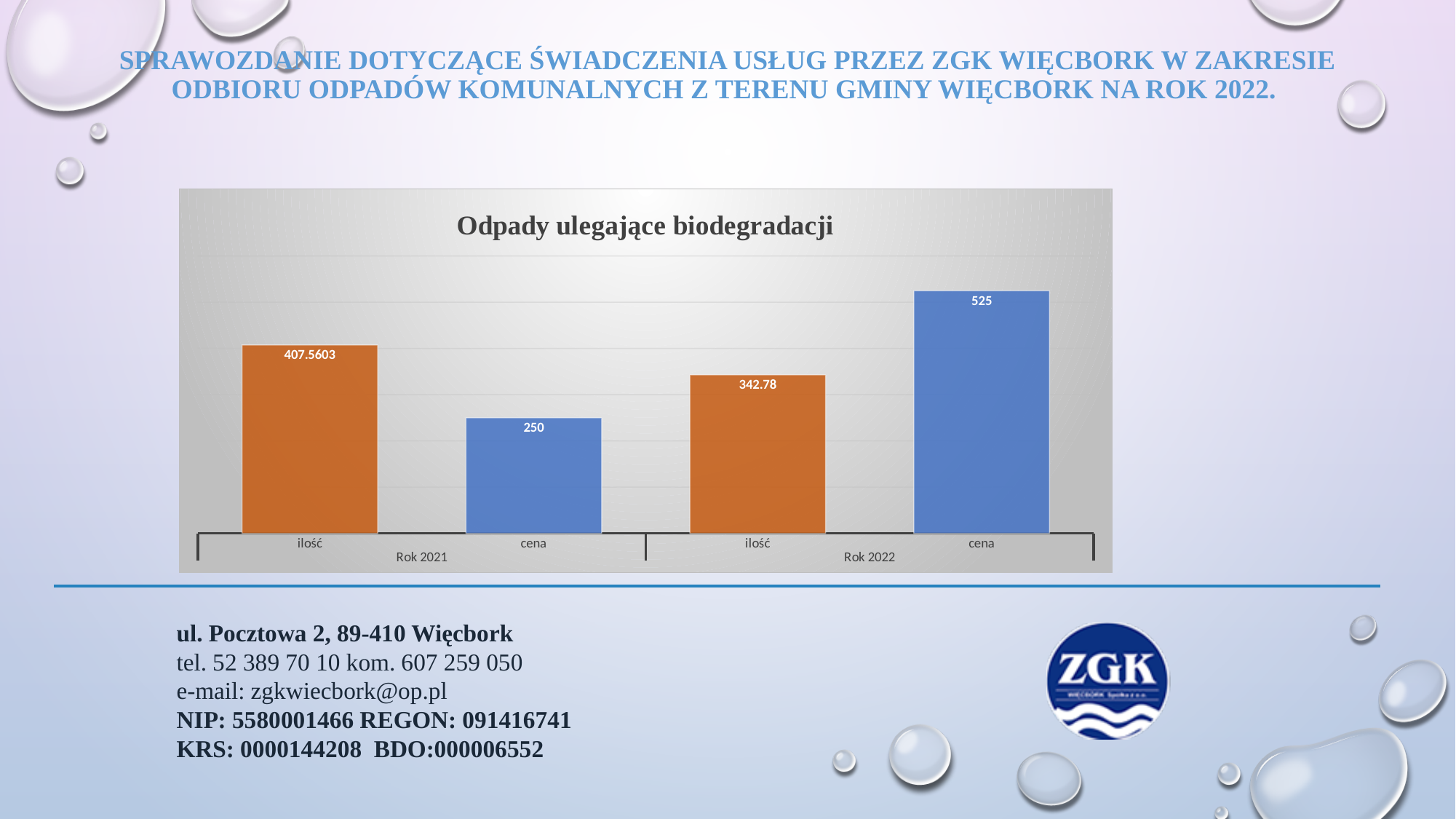
What is the difference between cena for Rok 2022 and cena for Rok 2021? 275 Which bar has the highest value in the chart? cena, Rok 2022 How many bars are plotted in the chart? 4 What is the value of cena for Rok 2022? 525 What is the value of ilość for Rok 2022? 342.78 Which bar has the lowest value in the chart? cena, Rok 2021 What type of chart is shown on the slide? bar chart Does the value of cena rise or fall from Rok 2021 to Rok 2022? rise What is the value of cena for Rok 2021? 250 Which is larger: ilość for Rok 2021 or ilość for Rok 2022? ilość for Rok 2021 What is the title of the chart? Odpady ulegające biodegradacji What is the value of ilość for Rok 2021? 407.5603